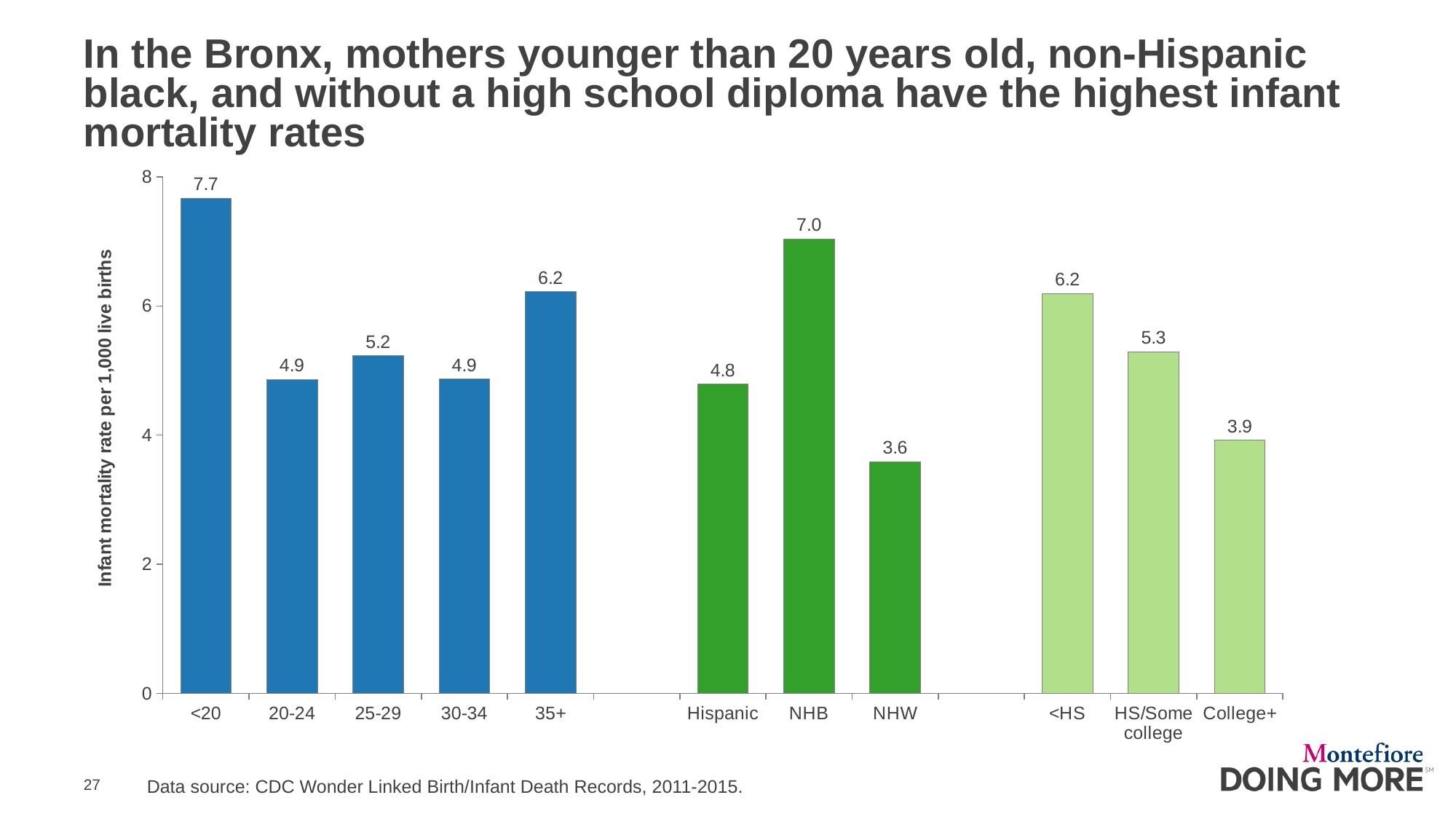
What kind of chart is shown on the slide? bar chart What is the infant mortality rate for the HS/Some college group? 5.3 What is the infant mortality rate for mothers younger than 20 (<20)? 7.7 Is the value for Hispanic greater or less than 6? less Which category has the highest infant mortality rate on the chart? <20 Which category has the lowest infant mortality rate on the chart? NHW How many categories are plotted on the chart? 11 What is the difference between the infant mortality rates for NHB and NHW? 3.4 Which has a higher infant mortality rate, the 35+ group or the 25-29 group? 35+ What is the infant mortality rate for the NHW group? 3.6 What is the label of the vertical axis? Infant mortality rate per 1,000 live births What is the difference between the infant mortality rates for <HS and College+? 2.3